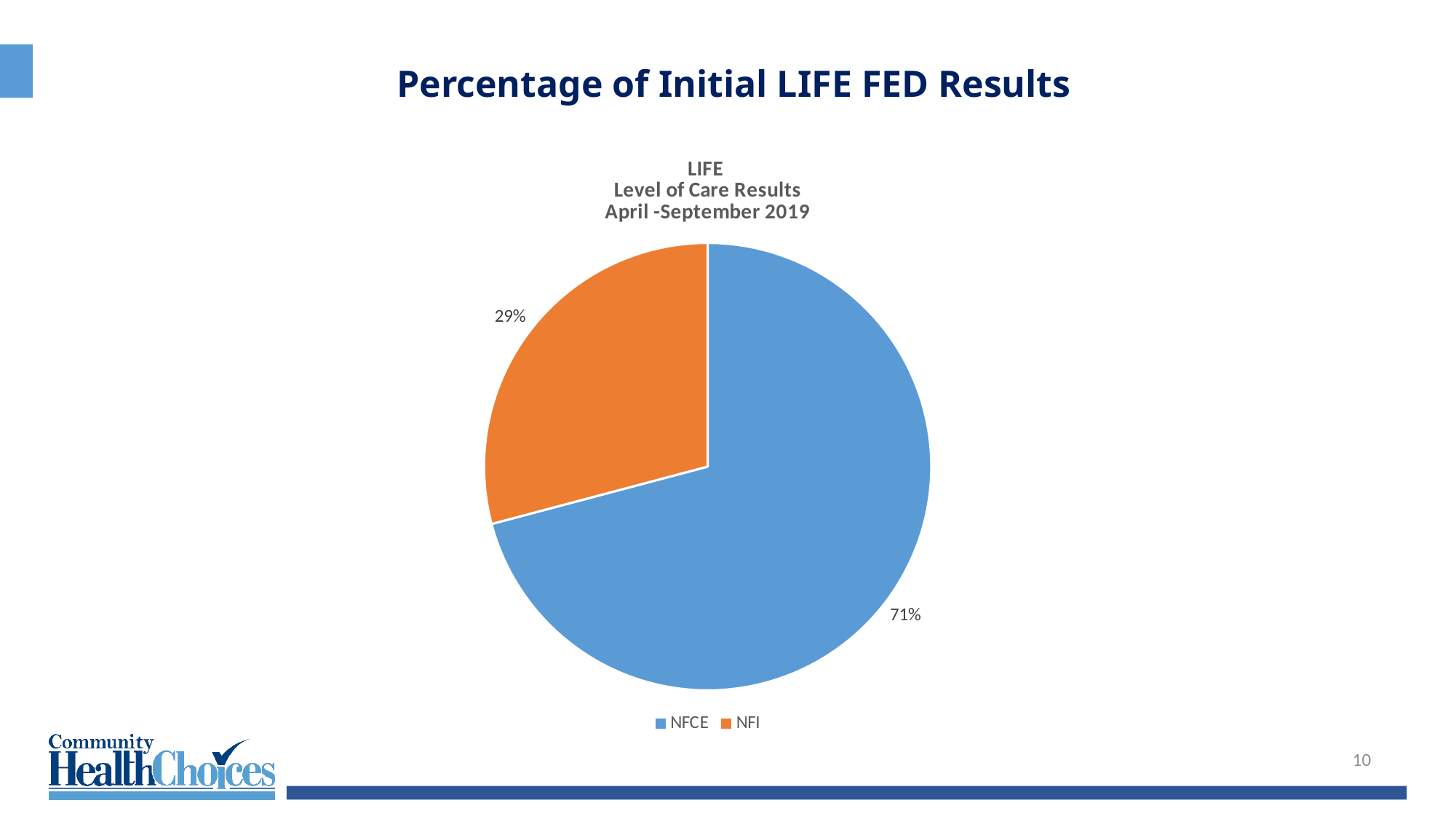
How many slices does the pie chart have? 2 What is the share of the pie taken by the NFI slice? 29% What percentage of the pie does NFCE represent? 71% Which is larger, the NFCE slice or the NFI slice? NFCE What percentage of the pie does NFI represent? 29% Which category has the largest share of the pie? NFCE What colour is the NFCE slice? blue What type of chart is shown on the slide? pie chart What time period is given in the chart title? April -September 2019 What is the difference in percentage points between the NFCE and NFI slices? 42 How many entries does the legend list? 2 Which category has the smallest share of the pie? NFI